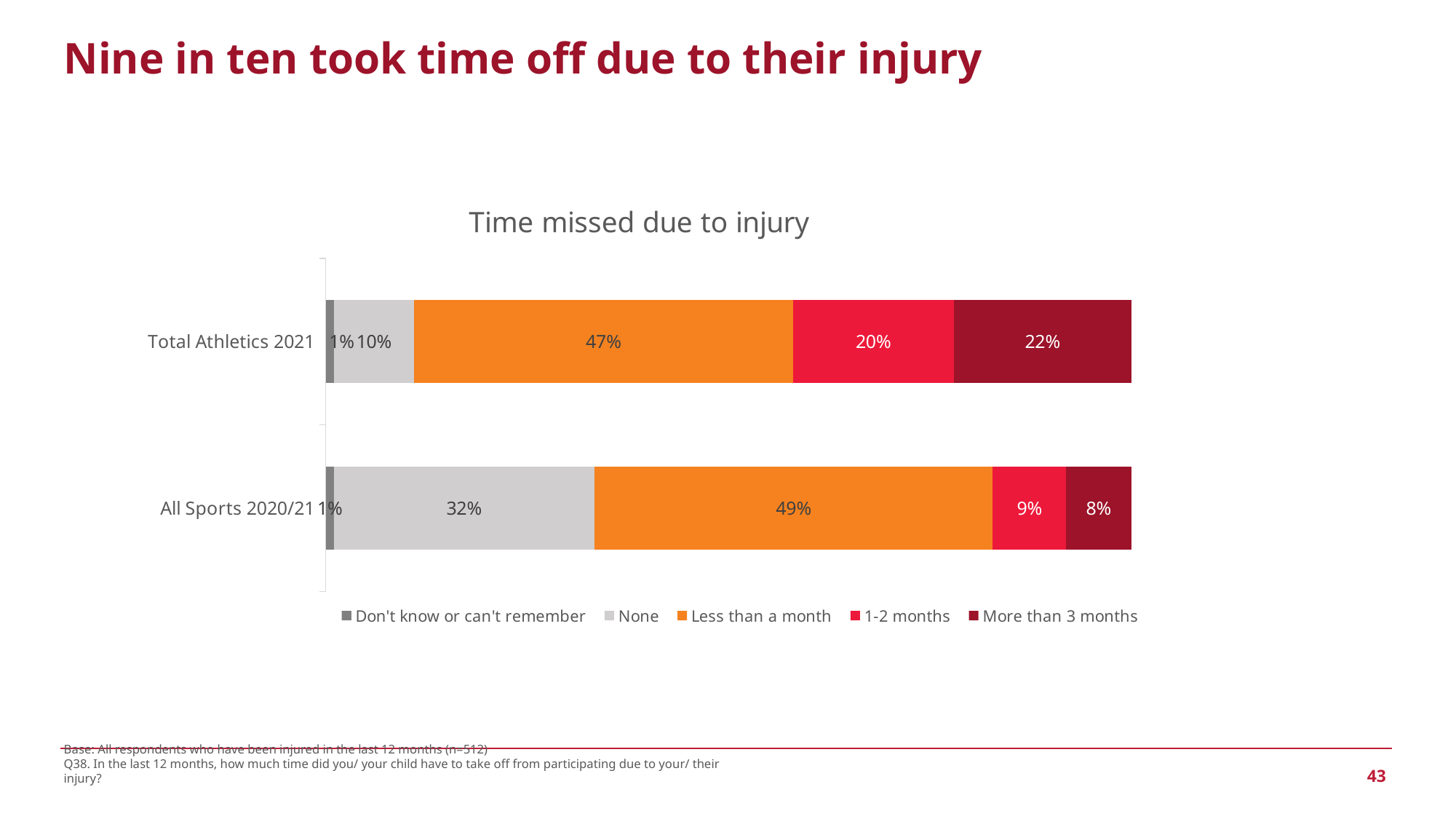
Which series has the highest value for All Sports 2020/21? Less than a month Which is larger: 'None' for Total Athletics 2021 or 'None' for All Sports 2020/21? All Sports 2020/21 What is the difference between the '1-2 months' values for Total Athletics 2021 and All Sports 2020/21? 11 percentage points Which series has the lowest value for Total Athletics 2021? Don't know or can't remember What is the value for 'None' for All Sports 2020/21? 32% What is the value for 'Less than a month' for Total Athletics 2021? 47% What kind of chart is shown? Stacked bar chart What is the value for '1-2 months' for All Sports 2020/21? 9% How many series does the legend list? 5 What is the value for 'More than 3 months' for Total Athletics 2021? 22% How many categories are shown on the chart? 2 What is the title of the chart? Time missed due to injury